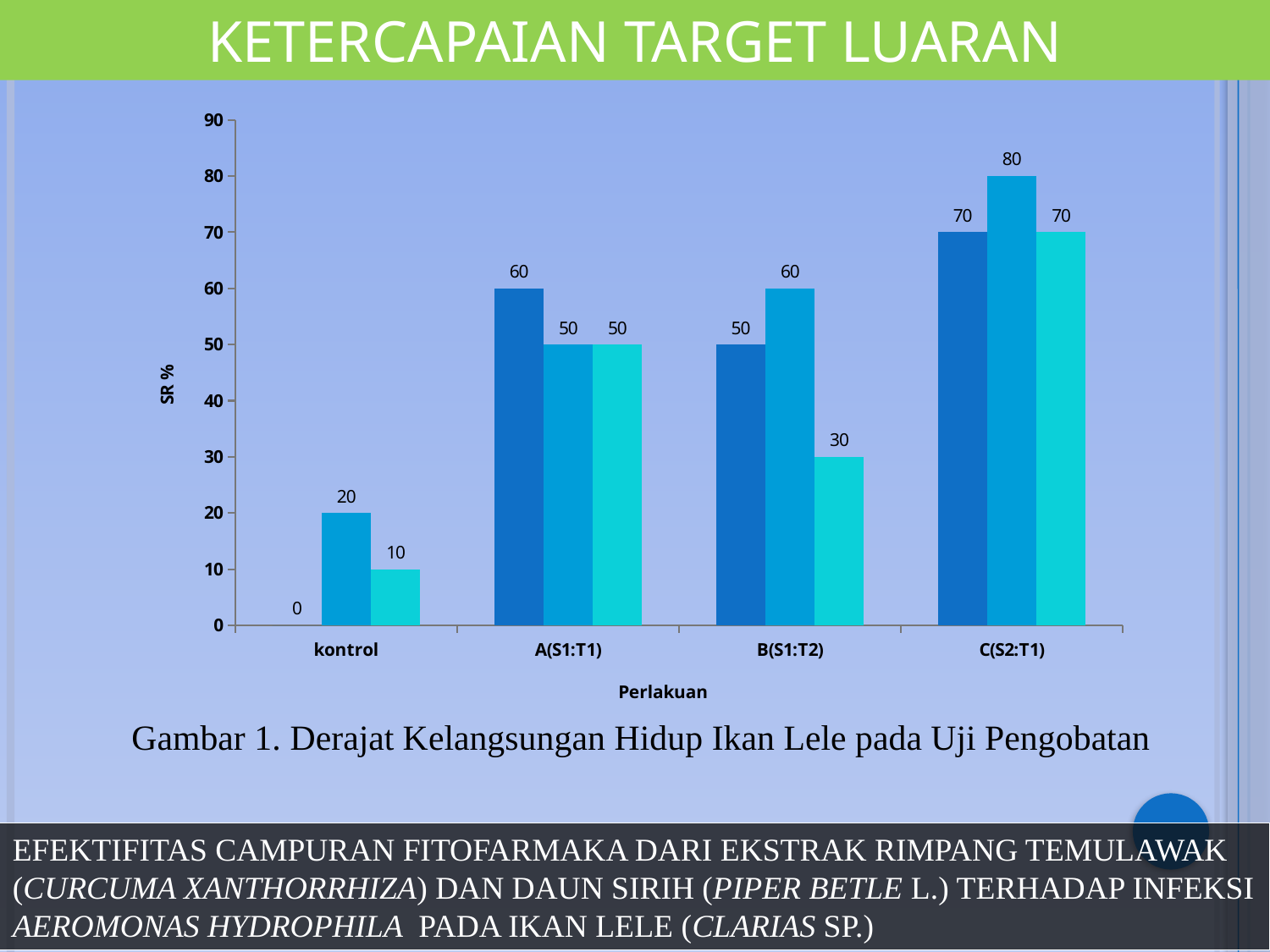
Which category has the lowest bar in the chart? kontrol What is the value of the first (dark blue) bar for A(S1:T1)? 60 Which category has the highest bar in the chart? C(S2:T1) What type of chart is shown on the slide? bar chart What is the difference between the second (medium blue) bar for C(S2:T1) and the second (medium blue) bar for B(S1:T2)? 20 How many categories are shown on the x axis (Perlakuan)? 4 Which is larger: the first (dark blue) bar for A(S1:T1) or the first (dark blue) bar for B(S1:T2)? A(S1:T1) What is the value of the third (cyan) bar for B(S1:T2)? 30 What is the value of the second (medium blue) bar for C(S2:T1)? 80 What is the value of the third (cyan) bar for kontrol? 10 What is the label of the y axis? SR % What is the value of the first (dark blue) bar for kontrol? 0